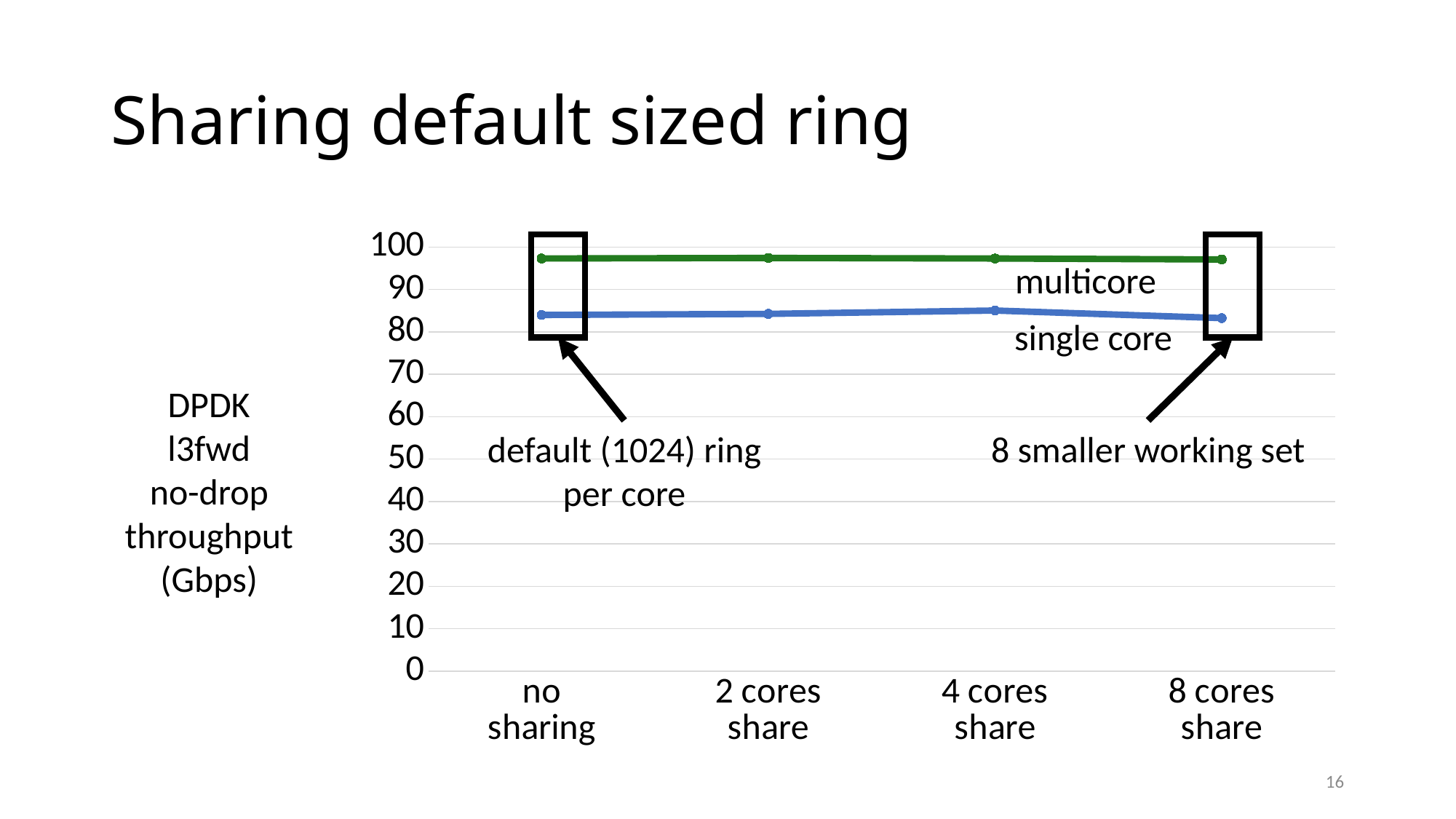
What is the title of the slide containing the chart? Sharing default sized ring Is the single core value for '8 cores share' greater or less than 90? less What is the label of the last category on the x axis? 8 cores share How many categories are shown on the x axis? 4 What kind of chart is shown on the slide? line chart At '4 cores share', which series has the higher value, multicore or single core? multicore Is the multicore value for '8 cores share' greater or less than 100? less How many series are plotted on the chart? 2 Which series is plotted in green? multicore Is the single core value for '2 cores share' greater or less than 80? greater Does the multicore series rise, fall, or stay roughly flat from 'no sharing' to '8 cores share'? stays roughly flat